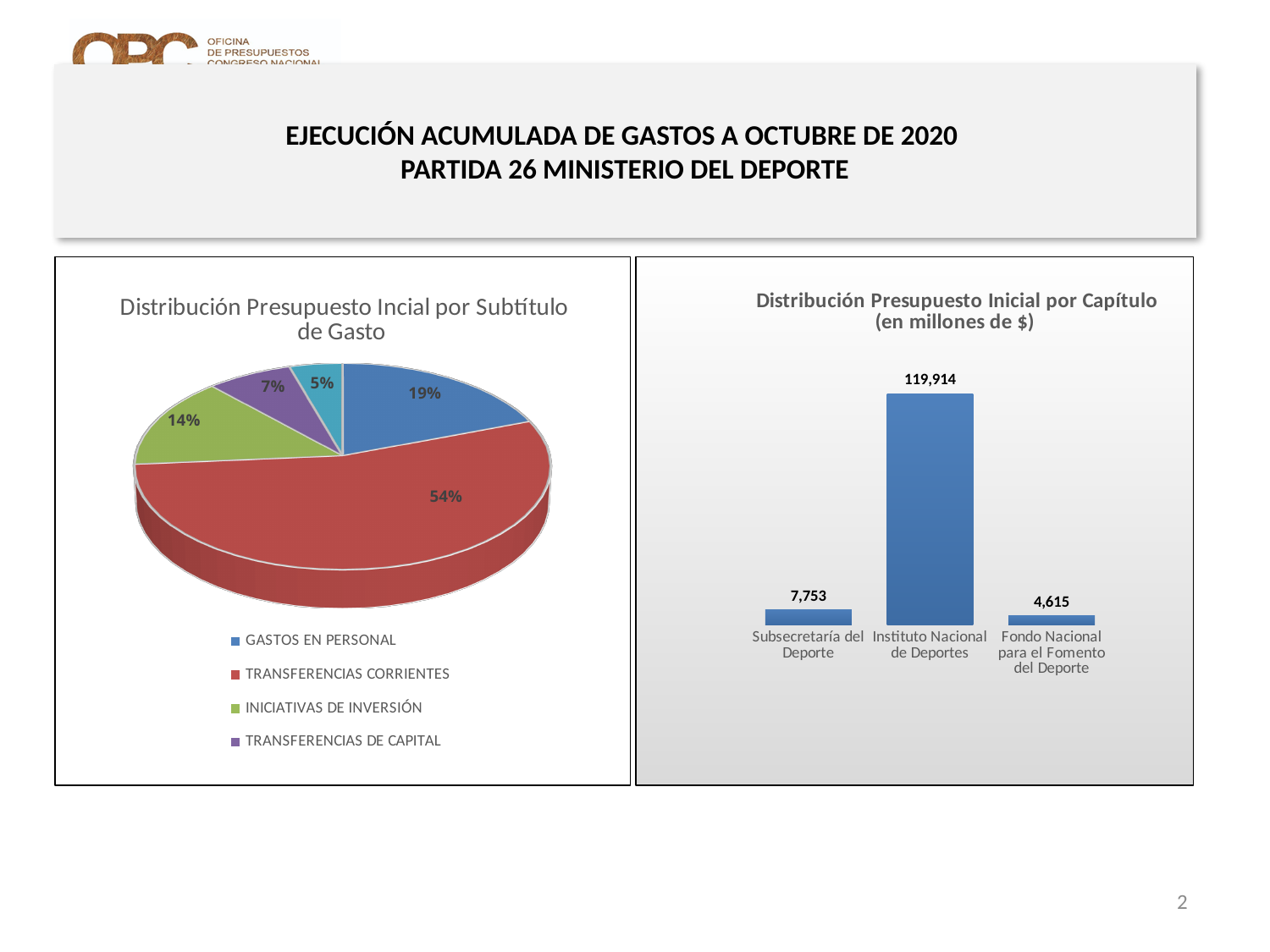
In the chart 'Distribución Presupuesto Inicial por Capítulo (en millones de $)', what is the difference between Subsecretaría del Deporte and Fondo Nacional para el Fomento del Deporte? 3,138 In the chart 'Distribución Presupuesto Inicial por Capítulo (en millones de $)', what is the value for Instituto Nacional de Deportes? 119,914 In the pie chart 'Distribución Presupuesto Incial por Subtítulo de Gasto', what share does INICIATIVAS DE INVERSIÓN have? 14% In the chart 'Distribución Presupuesto Inicial por Capítulo (en millones de $)', what is the value for Subsecretaría del Deporte? 7,753 In the pie chart 'Distribución Presupuesto Incial por Subtítulo de Gasto', what colour is the TRANSFERENCIAS DE CAPITAL slice? Purple In the chart 'Distribución Presupuesto Inicial por Capítulo (en millones de $)', how many categories are shown? 3 What kind of chart is 'Distribución Presupuesto Inicial por Capítulo (en millones de $)'? Bar chart In the chart 'Distribución Presupuesto Inicial por Capítulo (en millones de $)', which category has the lowest value? Fondo Nacional para el Fomento del Deporte In the pie chart 'Distribución Presupuesto Incial por Subtítulo de Gasto', which category has the largest share? TRANSFERENCIAS CORRIENTES In the pie chart 'Distribución Presupuesto Incial por Subtítulo de Gasto', what share does TRANSFERENCIAS CORRIENTES have? 54% In the pie chart 'Distribución Presupuesto Incial por Subtítulo de Gasto', what share does GASTOS EN PERSONAL have? 19% In the pie chart 'Distribución Presupuesto Incial por Subtítulo de Gasto', how many entries does the legend list? 4